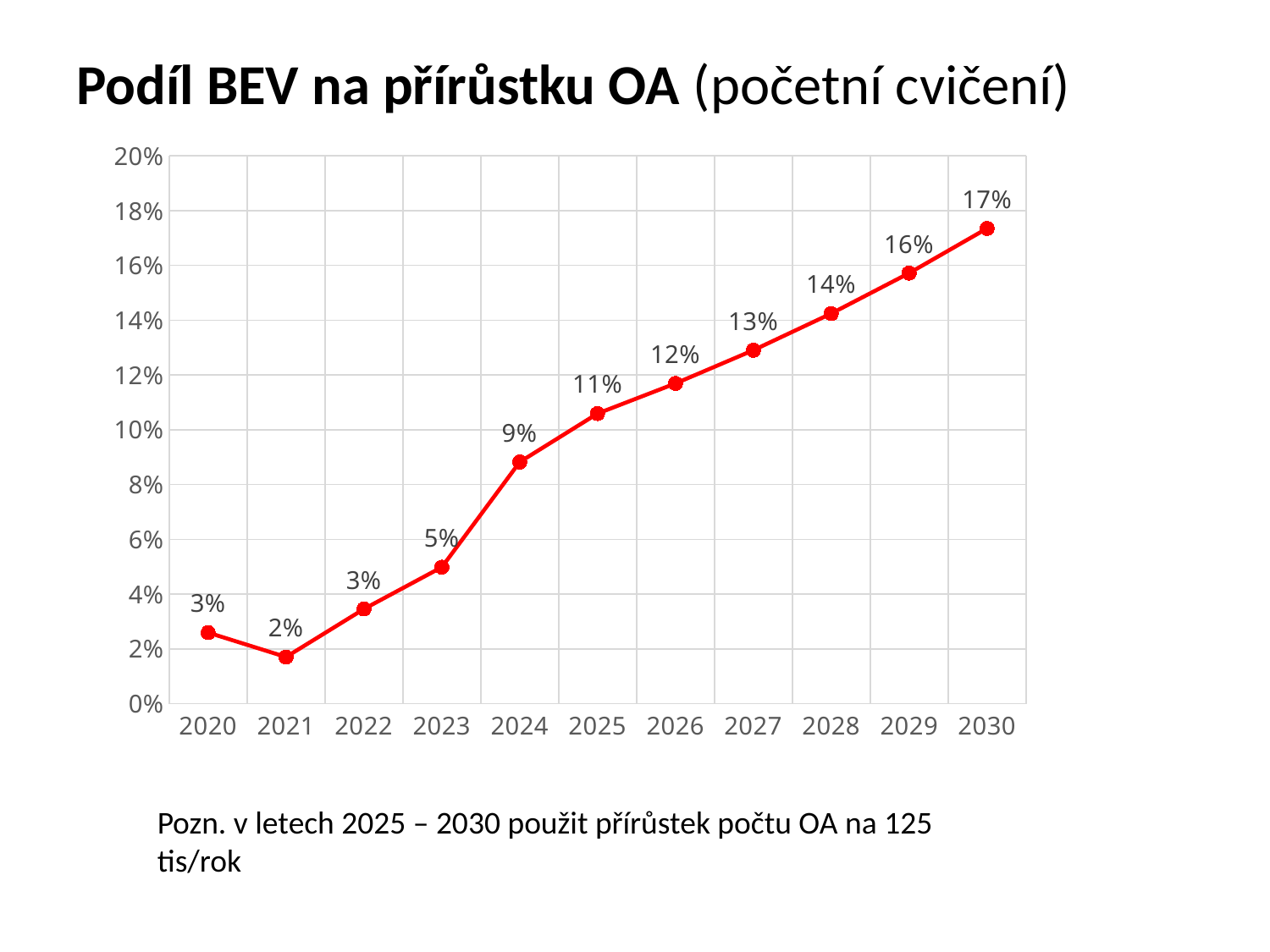
What is the title of the chart? Podíl BEV na přírůstku OA (početní cvičení) What is the difference between the values for 2030 and 2020? 14% Which year has the highest value? 2030 What kind of chart is shown? line chart Which is larger, the value for 2025 or the value for 2023? 2025 Do the values generally rise or fall from 2021 to 2030? rise What is the value for 2024? 9% Is the value for 2027 greater or less than 10%? greater Which year has the lowest value? 2021 How many years are plotted on the chart? 11 What is the value for 2021? 2% What is the value for 2030? 17%